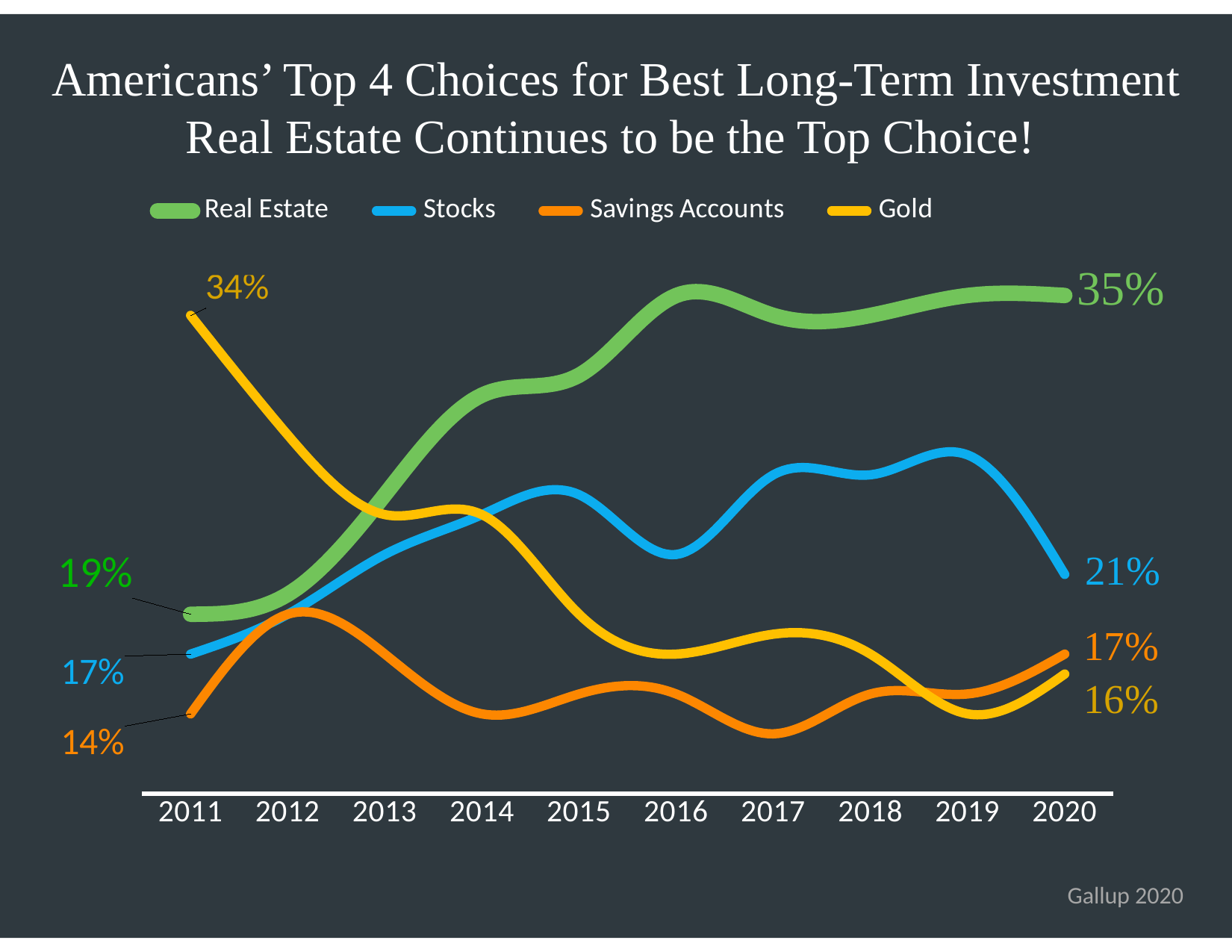
What was the value for Real Estate in 2020? 35% How many series does the legend list? 4 What kind of chart is shown on the slide? line chart Does the Gold line rise or fall from 2011 to 2020? fall How many years are shown along the x axis? 10 In 2020, which is larger: the value for Stocks or the value for Savings Accounts? Stocks What was the value for Savings Accounts in 2011? 14% What was the value for Gold in 2011? 34% Which investment had the highest value in 2011? Gold Which investment had the lowest value in 2020? Gold What is the difference between the Real Estate value in 2020 and its value in 2011? 16% What was the value for Stocks in 2020? 21%